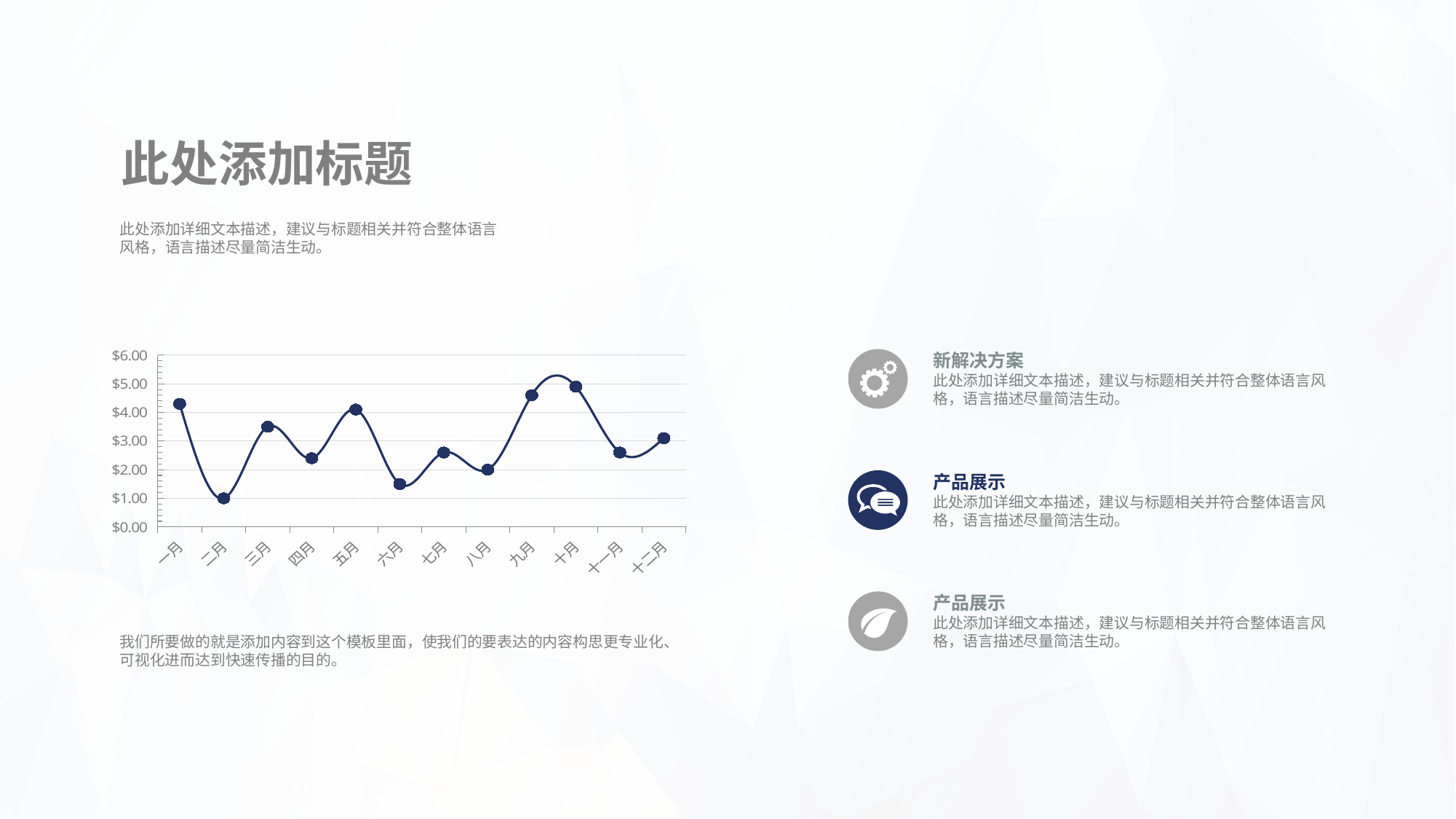
Do the values rise or fall from 八月 to 十月? rise What is the highest tick label shown on the y axis of the chart? $6.00 Which is larger, the value for 三月 or the value for 四月? 三月 How many months are plotted along the x axis of the chart? 12 Which month has the highest value in the chart? 十月 Which month has the lowest value in the chart? 二月 Is the value for 一月 greater or less than $4.00? greater What is the value for 八月 in the chart? $2.00 What kind of chart is shown on the slide? line chart What is the value for 二月 in the chart? $1.00 Is the value for 十一月 greater or less than $3.00? less Is the value for 六月 greater or less than $2.00? less